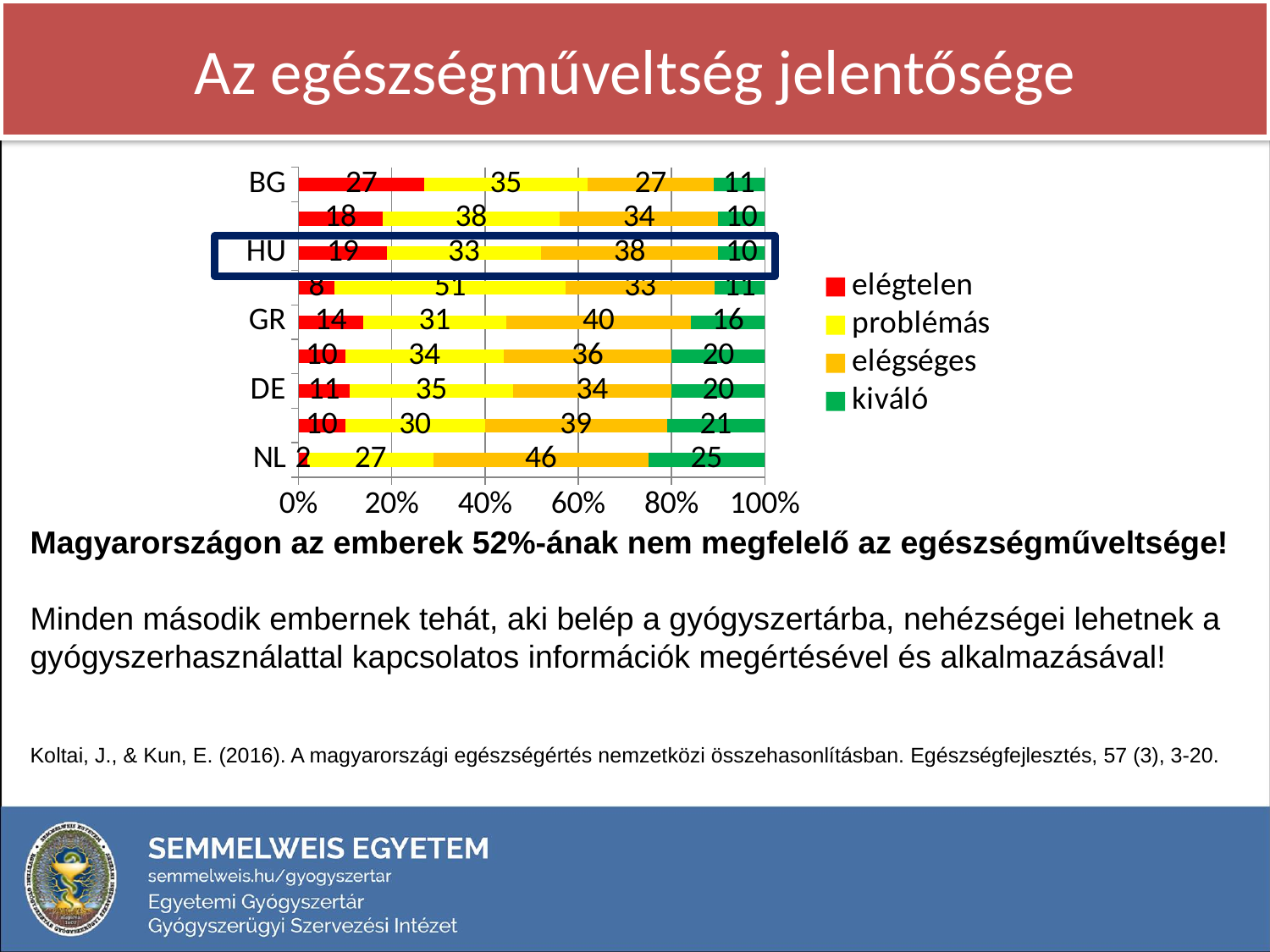
What is the value of the elégséges segment for GR? 40 What is the value of the kiváló segment for NL? 25 What colour represents the kiváló series in the legend? Green What is the total of the stacked bar for HU? 100 Which country has the lowest elégtelen value? NL What is the value of the problémás segment for BG? 35 How many series does the legend list? 4 Which has a larger kiváló value, DE or HU? DE What is the value of the elégtelen segment for HU? 19 What is the difference between the elégséges values for HU and BG? 11 Which country has the highest elégtelen value? BG What kind of chart is shown on the slide? Stacked bar chart